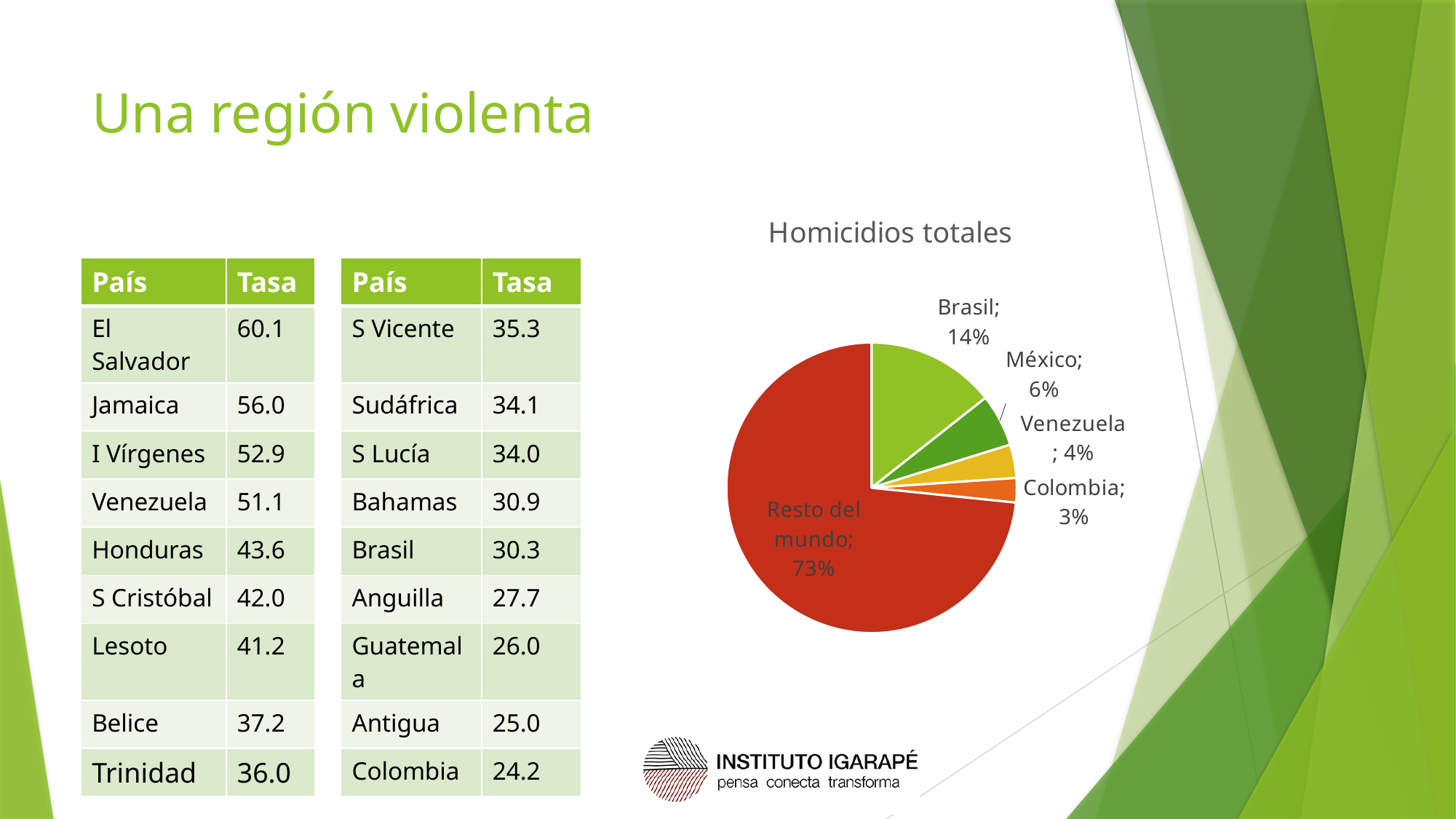
How many slices does the pie chart have? 5 What share of the pie does México have? 6% What is the difference in percentage points between the Brasil slice and the México slice? 8% What is the title of the chart on the slide? Homicidios totales What share of the pie does Colombia have? 3% Which slice is larger, Venezuela or Colombia? Venezuela Which slice of the pie is the smallest? Colombia What share of the pie does 'Resto del mundo' have? 73% Which slice of the pie is the largest? Resto del mundo What kind of chart is 'Homicidios totales'? pie chart